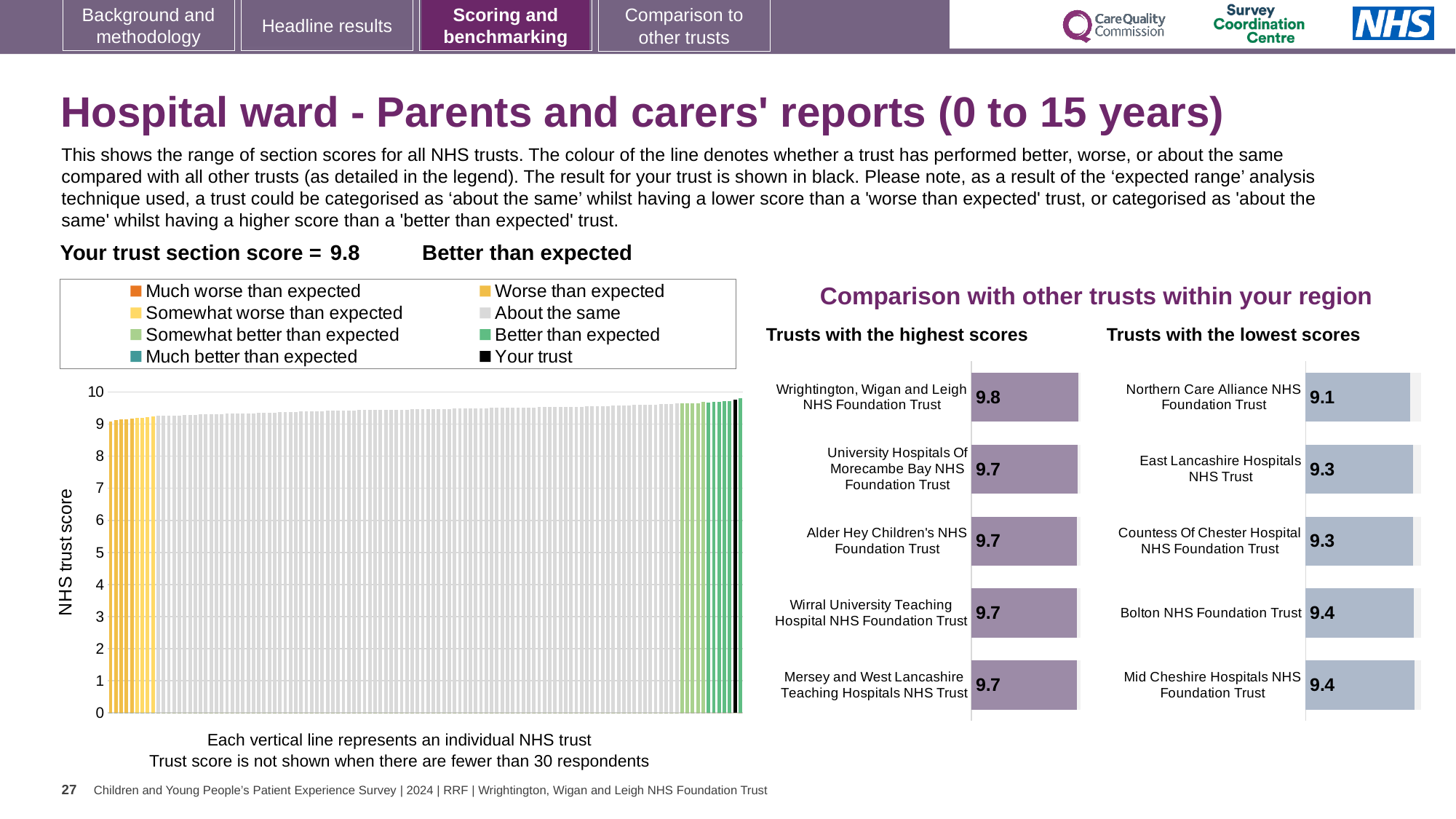
In the 'Trusts with the lowest scores' chart, which has the larger score: East Lancashire Hospitals NHS Trust or Mid Cheshire Hospitals NHS Foundation Trust? Mid Cheshire Hospitals NHS Foundation Trust In the 'Trusts with the lowest scores' chart, what is the difference between the scores of Bolton NHS Foundation Trust and Northern Care Alliance NHS Foundation Trust? 0.3 How many entries does the legend of the main 'NHS trust score' chart list? 8 In the 'Trusts with the highest scores' chart, what is the score for Wrightington, Wigan and Leigh NHS Foundation Trust? 9.8 In the 'Trusts with the lowest scores' chart, which trust has the lowest score? Northern Care Alliance NHS Foundation Trust In the 'Trusts with the lowest scores' chart, what is the score for Northern Care Alliance NHS Foundation Trust? 9.1 In the main 'NHS trust score' chart, do the bar values rise or fall from left to right along the x axis? Rise In the 'Trusts with the highest scores' chart, which trust has the highest score? Wrightington, Wigan and Leigh NHS Foundation Trust In the 'Trusts with the highest scores' chart, what is the score for Alder Hey Children's NHS Foundation Trust? 9.7 What kind of chart is the main chart on the left with the 'NHS trust score' axis? Bar chart In the 'Trusts with the lowest scores' chart, what is the score for Bolton NHS Foundation Trust? 9.4 How many trusts are shown in the 'Trusts with the highest scores' chart? 5